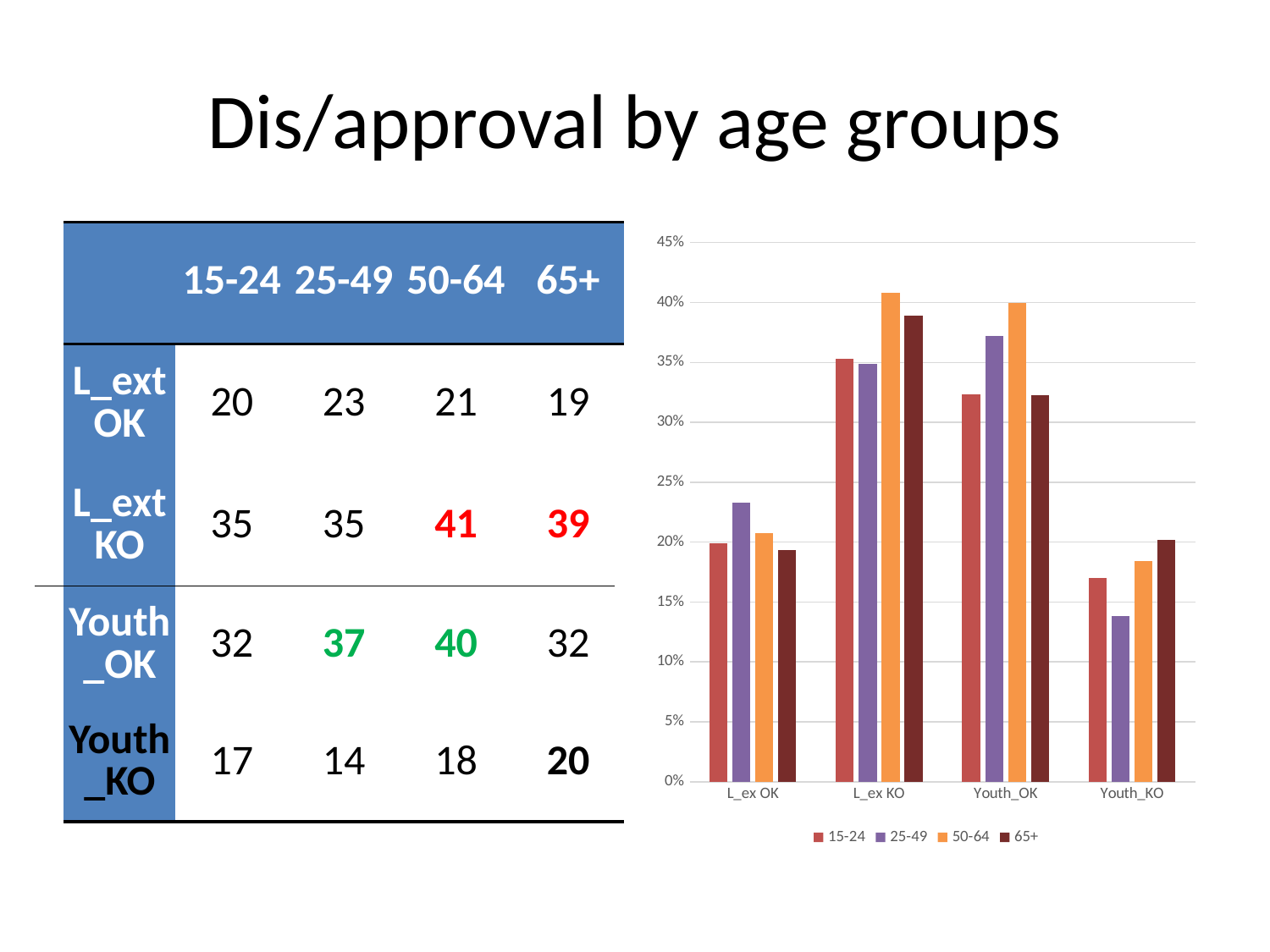
What kind of chart is shown on the slide? bar chart Which age group has the highest bar in the Youth_OK category? 50-64 What are the entries listed in the chart's legend? 15-24, 25-49, 50-64, 65+ Which age group has the lowest bar in the Youth_KO category? 25-49 Is the value for 25-49 in the Youth_KO category greater or less than 15%? less Is the value for 50-64 in the Youth_OK category greater or less than 35%? greater Which age group has the highest bar in the L_ex OK category? 25-49 Which is larger: the 15-24 bar for L_ex KO or the 15-24 bar for Youth_OK? L_ex KO Which age group has the highest bar in the L_ex KO category? 50-64 Which is larger in the Youth_KO category: the 65+ bar or the 15-24 bar? 65+ How many series does the chart's legend list? 4 How many categories are shown along the x axis of the chart? 4